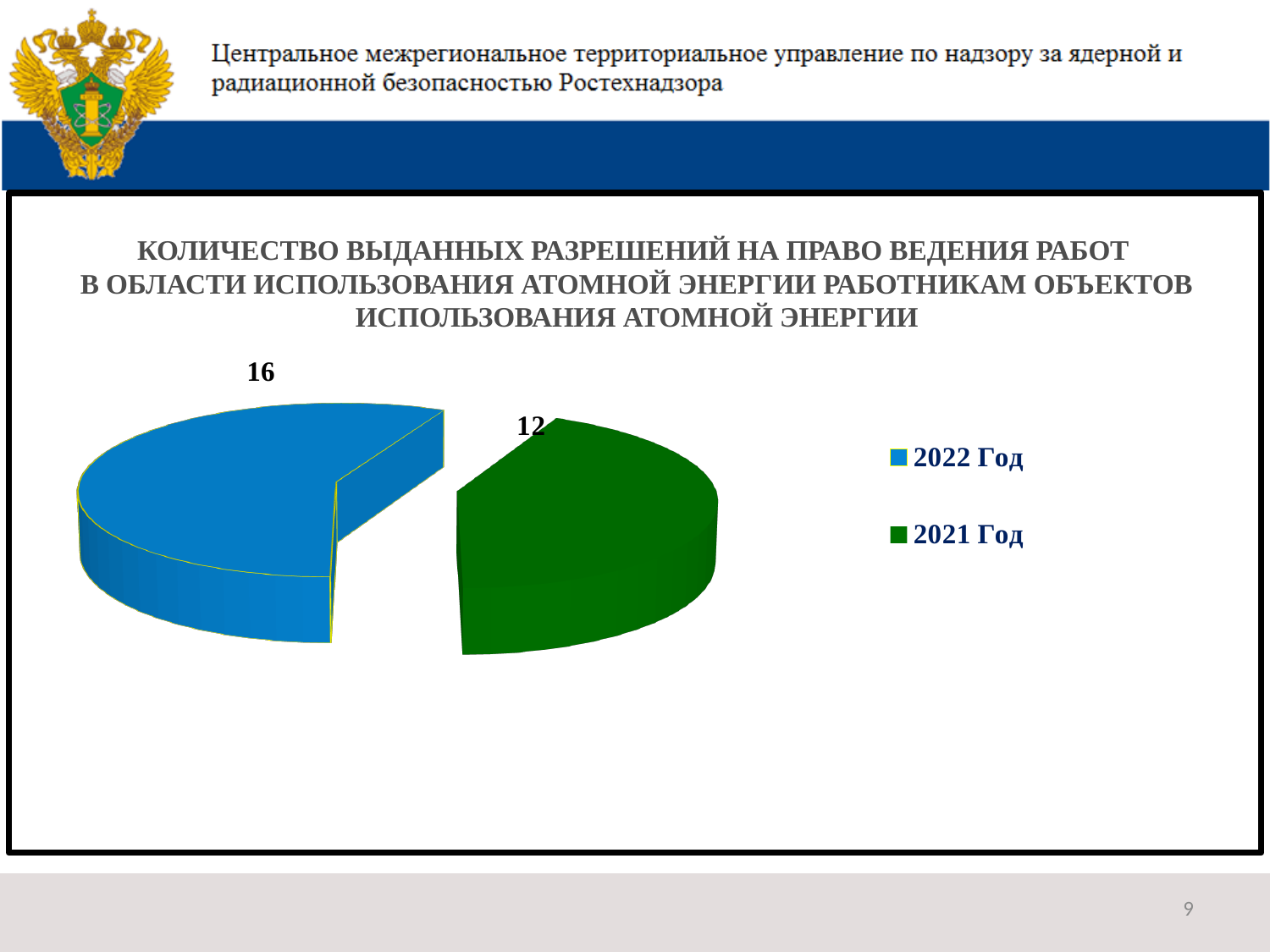
How many slices does the pie chart have? 2 What is the total of the two values shown in the pie chart? 28 What is the difference between the values for 2022 Год and 2021 Год? 4 Which year has the larger slice in the pie chart? 2022 Год What value is shown for the 2022 Год slice of the pie chart? 16 How many entries does the legend list? 2 Which year has the smaller slice in the pie chart? 2021 Год What kind of chart is shown on the slide? pie chart What value is shown for the 2021 Год slice of the pie chart? 12 Is the value for 2022 Год larger or smaller than the value for 2021 Год? larger What colour is the slice for 2021 Год? green